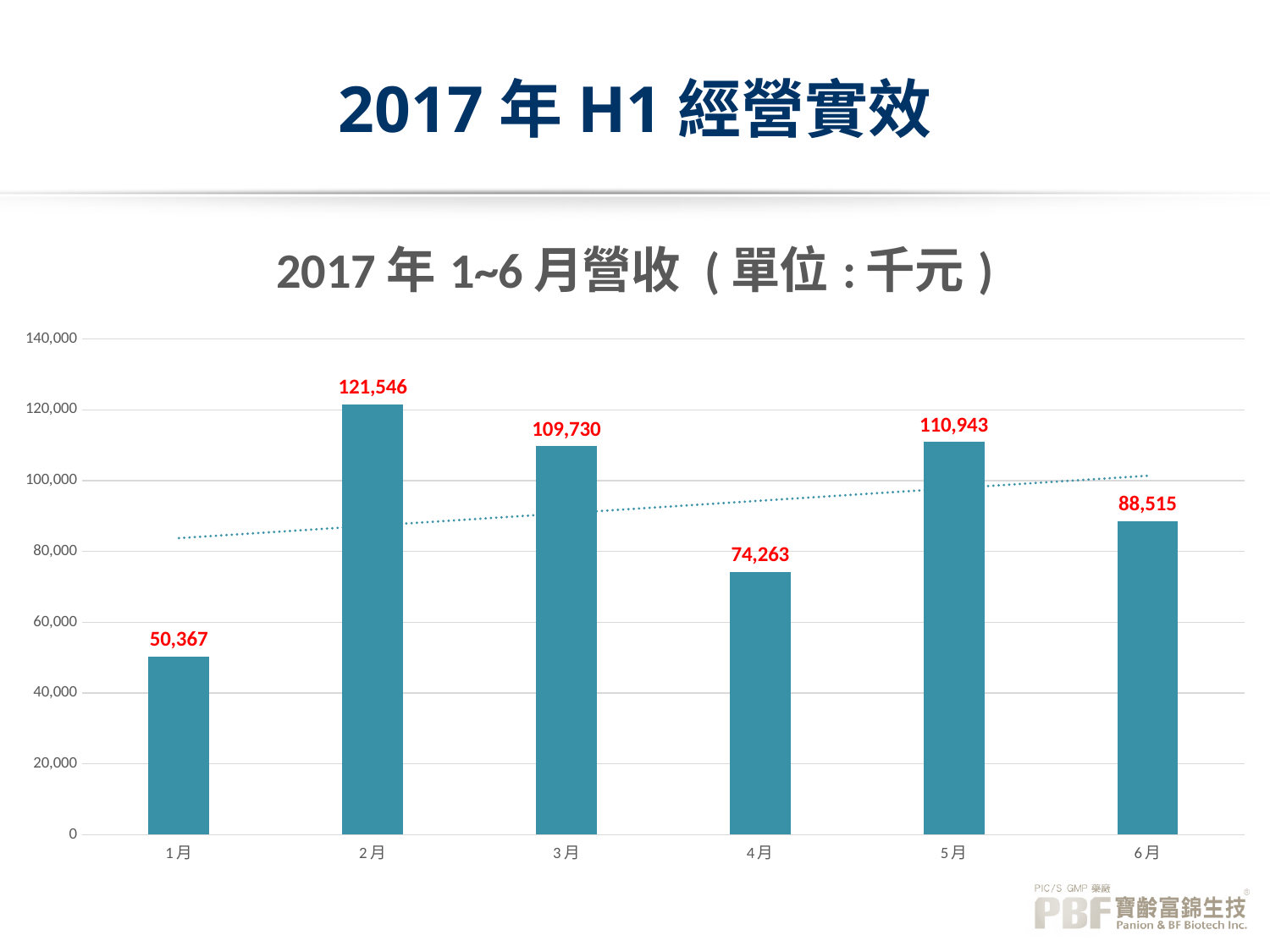
What is the difference between the revenue for 5月 and 3月? 1,213 What is the title of the chart? 2017 年 1~6 月營收（單位 : 千元） Which month has the highest revenue? 2月 What is the revenue value for 4月? 74,263 What is the revenue value for 2月? 121,546 Which month has the lowest revenue? 1月 What is the revenue value for 6月? 88,515 Is the value for 4月 greater or less than 80,000? less What is the difference between the revenue for 2月 and 1月? 71,179 Which is larger, the revenue for 3月 or 6月? 3月 How many months are shown on the chart? 6 What kind of chart is shown on the slide? bar chart